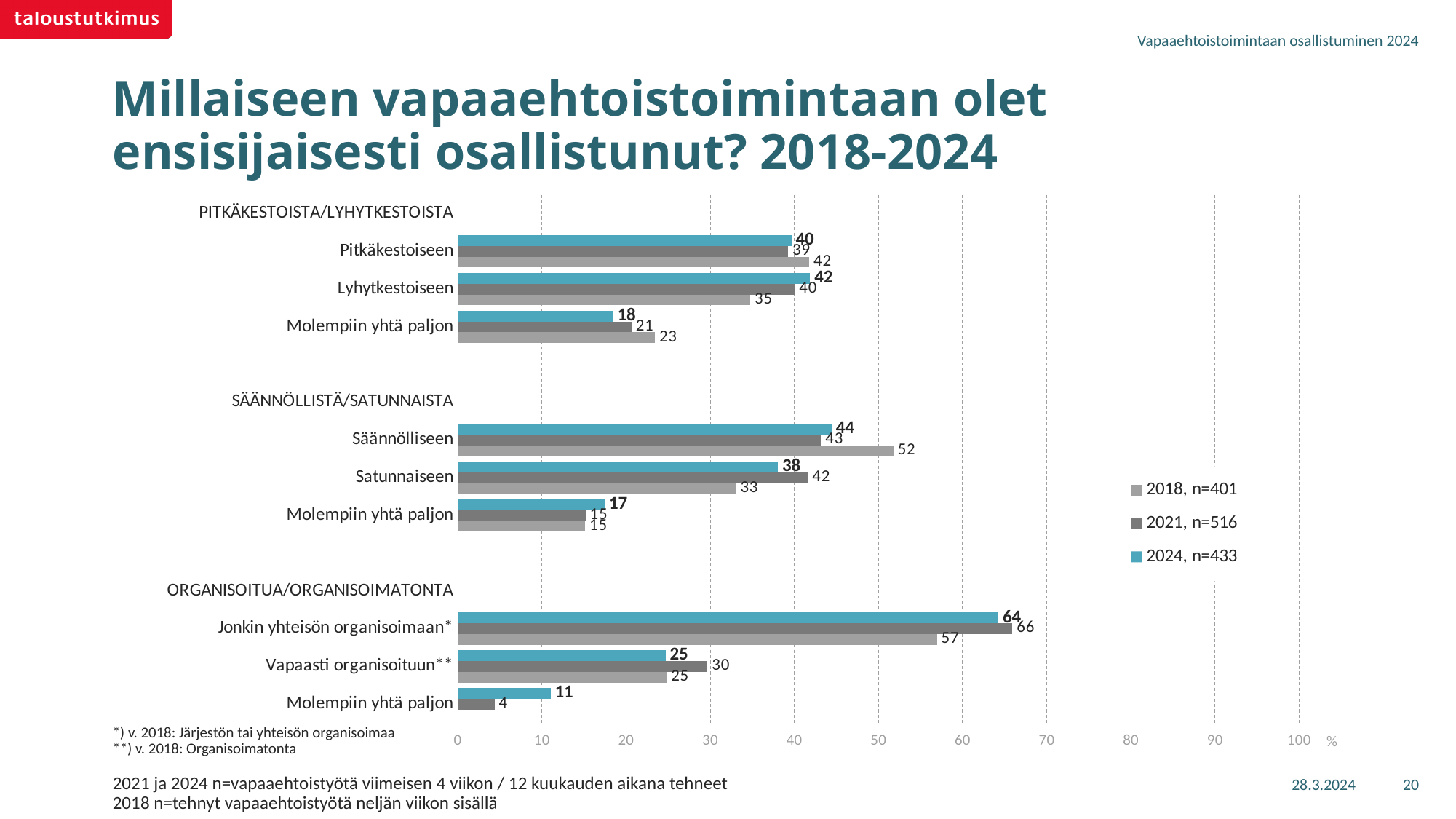
Which category has the lowest 2021 value? Molempiin yhtä paljon (Organisoitua/organisoimatonta) What is the 2024 value for Lyhytkestoiseen? 42 What is the 2024 value for Jonkin yhteisön organisoimaan*? 64 Which is larger for Satunnaiseen: the 2021 value or the 2018 value? 2021 How many series does the legend list? 3 Which category has the highest 2024 value? Jonkin yhteisön organisoimaan* What is the 2021 value for Vapaasti organisoituun**? 30 What kind of chart is shown on the slide? bar chart What is the sample size (n) for the 2021 series in the legend? 516 What is the difference between the 2018 and 2024 values for Säännölliseen? 8 What is the difference between the 2021 and 2024 values for Molempiin yhtä paljon in the Organisoitua/organisoimatonta group? 7 What is the 2018 value for Säännölliseen? 52